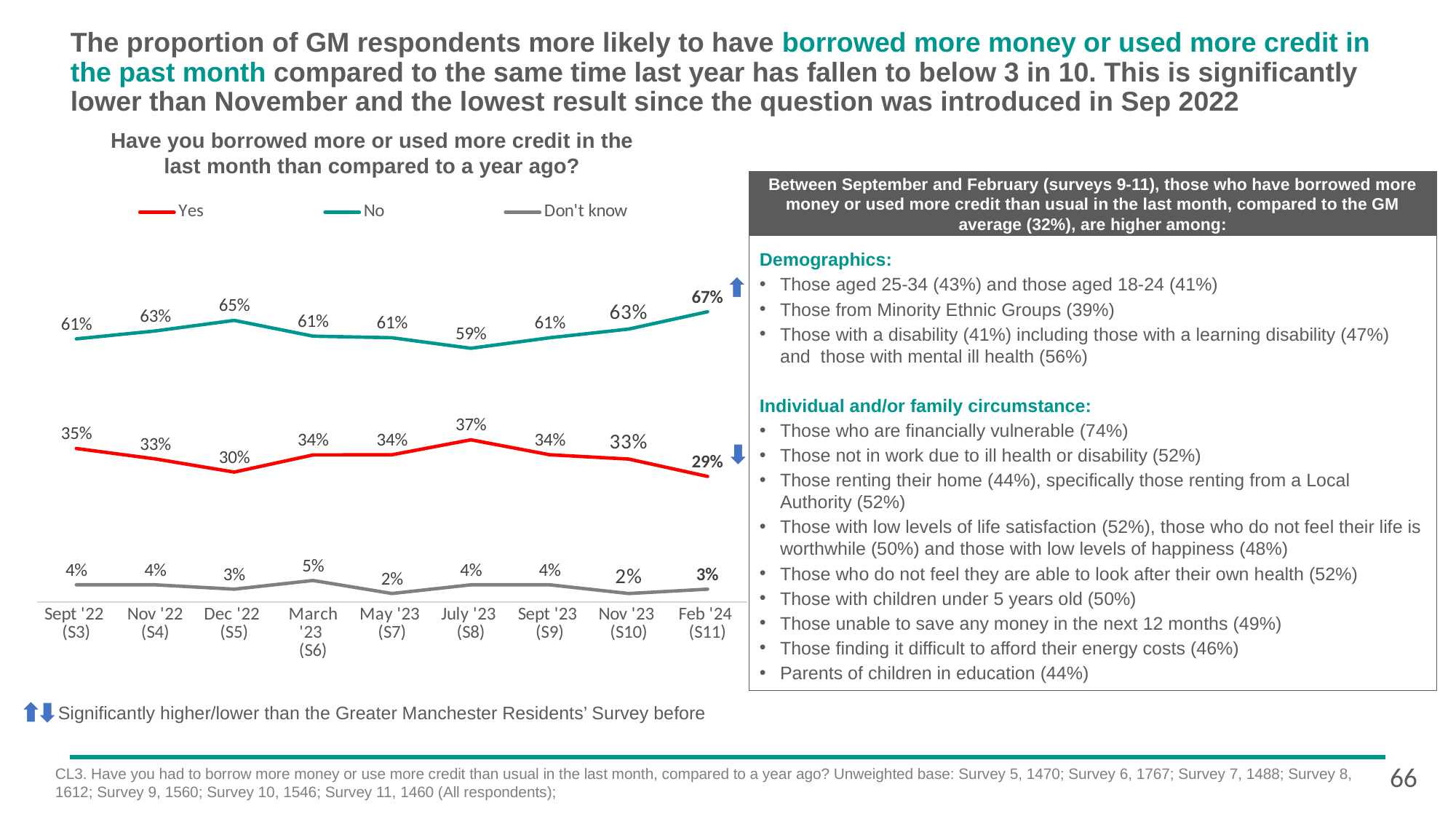
How many survey waves are shown on the x axis of the chart? 9 What percentage of respondents answered 'No' in July '23 (S8)? 59% What percentage of respondents answered 'Don't know' in March '23 (S6)? 5% In which survey wave was the 'No' series at its lowest? July '23 (S8) What is the difference between the 'No' and 'Yes' values in Feb '24 (S11)? 38 percentage points What percentage of respondents answered 'Yes' in Feb '24 (S11)? 29% In which survey wave was the 'Yes' series at its highest? July '23 (S8) By how many percentage points did the 'Yes' value fall from Nov '23 (S10) to Feb '24 (S11)? 4 percentage points Which was higher for 'Yes': Sept '22 (S3) or Dec '22 (S5)? Sept '22 (S3) What type of chart is used to show the survey responses? Line chart How many series does the chart legend list? 3 What colour is the 'Yes' line in the chart? Red